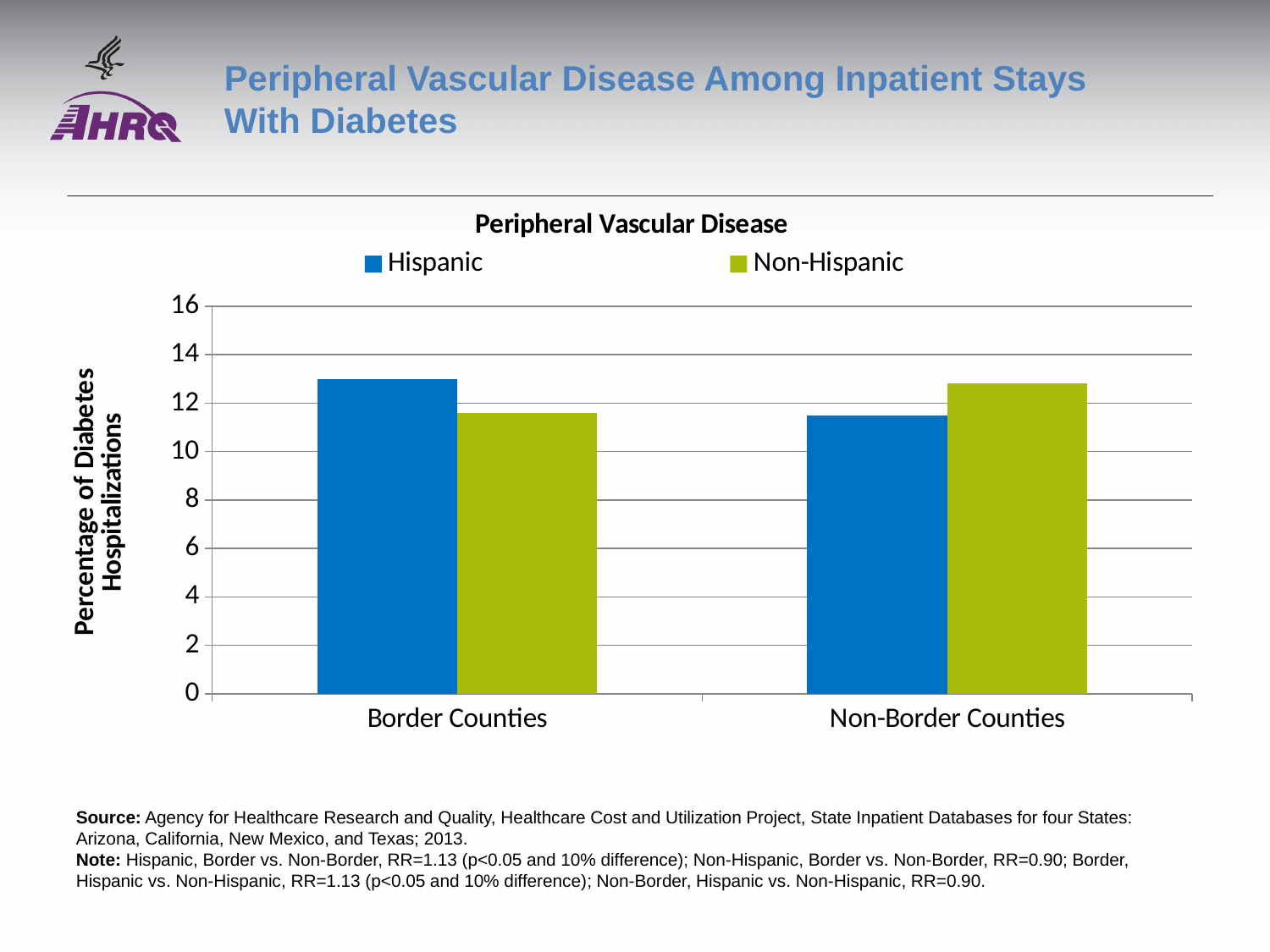
What kind of chart is shown on the slide? bar chart How many county categories are shown on the x axis? 2 For the Hispanic series, which is higher, Border Counties or Non-Border Counties? Border Counties In Border Counties, which group has the higher value, Hispanic or Non-Hispanic? Hispanic Is the Hispanic value for Non-Border Counties greater or less than 12? less Is the Hispanic value for Border Counties greater or less than 12? greater In Non-Border Counties, which group has the higher value, Hispanic or Non-Hispanic? Non-Hispanic What is the title of the chart? Peripheral Vascular Disease Is the Non-Hispanic value for Non-Border Counties greater or less than 12? greater How many series does the chart legend list? 2 What is the label on the vertical axis? Percentage of Diabetes Hospitalizations